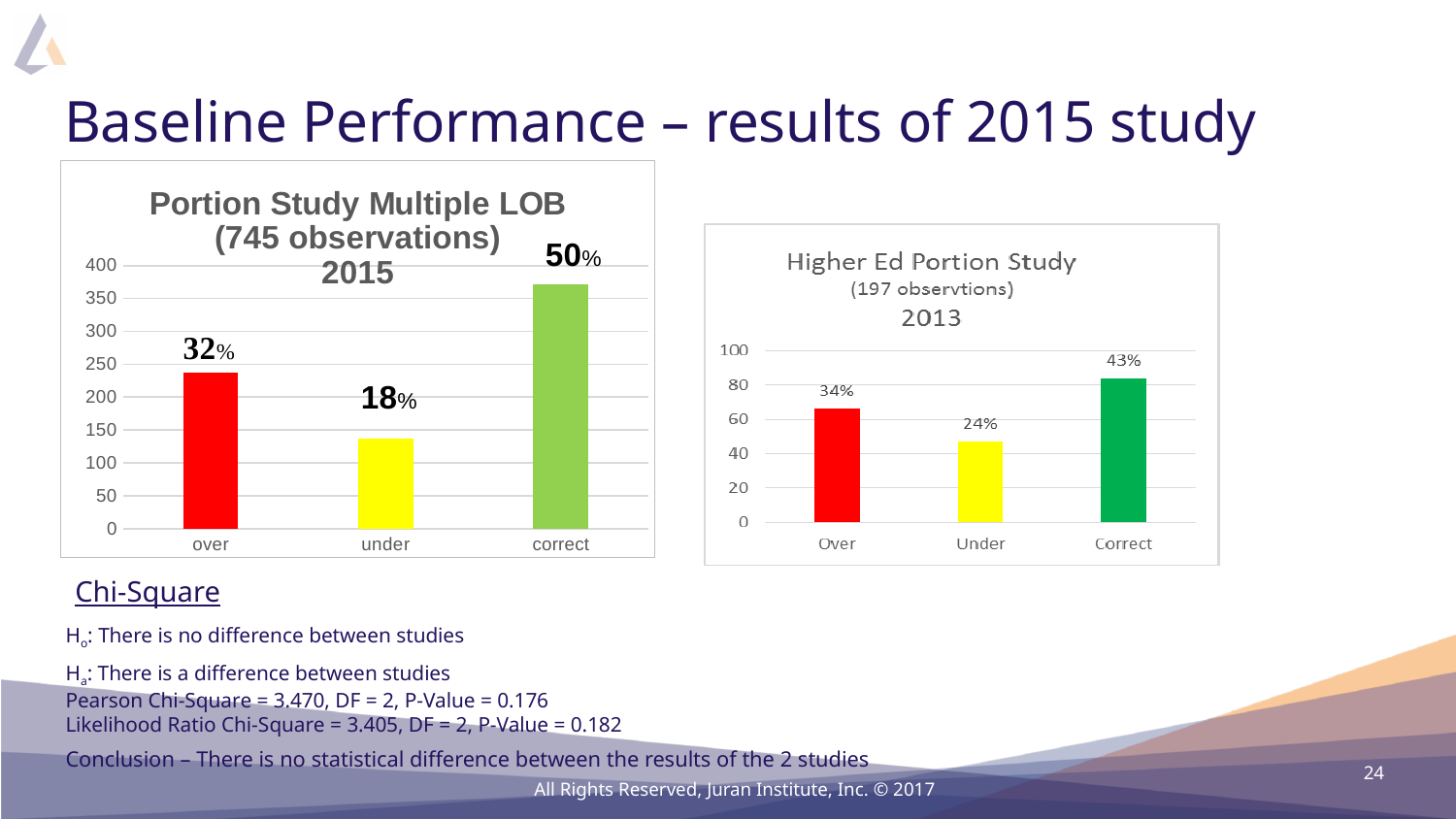
In the Higher Ed Portion Study chart, what percentage is shown for 'Over'? 34% In the Higher Ed Portion Study chart, what is the difference in percentage points between the 'Correct' and 'Under' labels? 19% In the Higher Ed Portion Study chart, what percentage is shown for 'Correct'? 43% In the Higher Ed Portion Study chart, is the bar for 'Under' greater or less than 60 on the axis? less How many categories are shown in the Higher Ed Portion Study chart? 3 In the Portion Study Multiple LOB chart, which category has the highest bar? correct What type of chart is the Portion Study Multiple LOB chart? Bar chart In the Portion Study Multiple LOB chart, what percentage is shown for the 'under' bar? 18% In the Portion Study Multiple LOB chart, what is the difference in percentage points between the 'correct' and 'under' labels? 32% In the Portion Study Multiple LOB chart, what percentage is shown for the 'correct' bar? 50% In the Portion Study Multiple LOB chart, is the bar for 'over' greater or less than 200 on the axis? greater In the Higher Ed Portion Study chart, which category has the lowest bar? Under